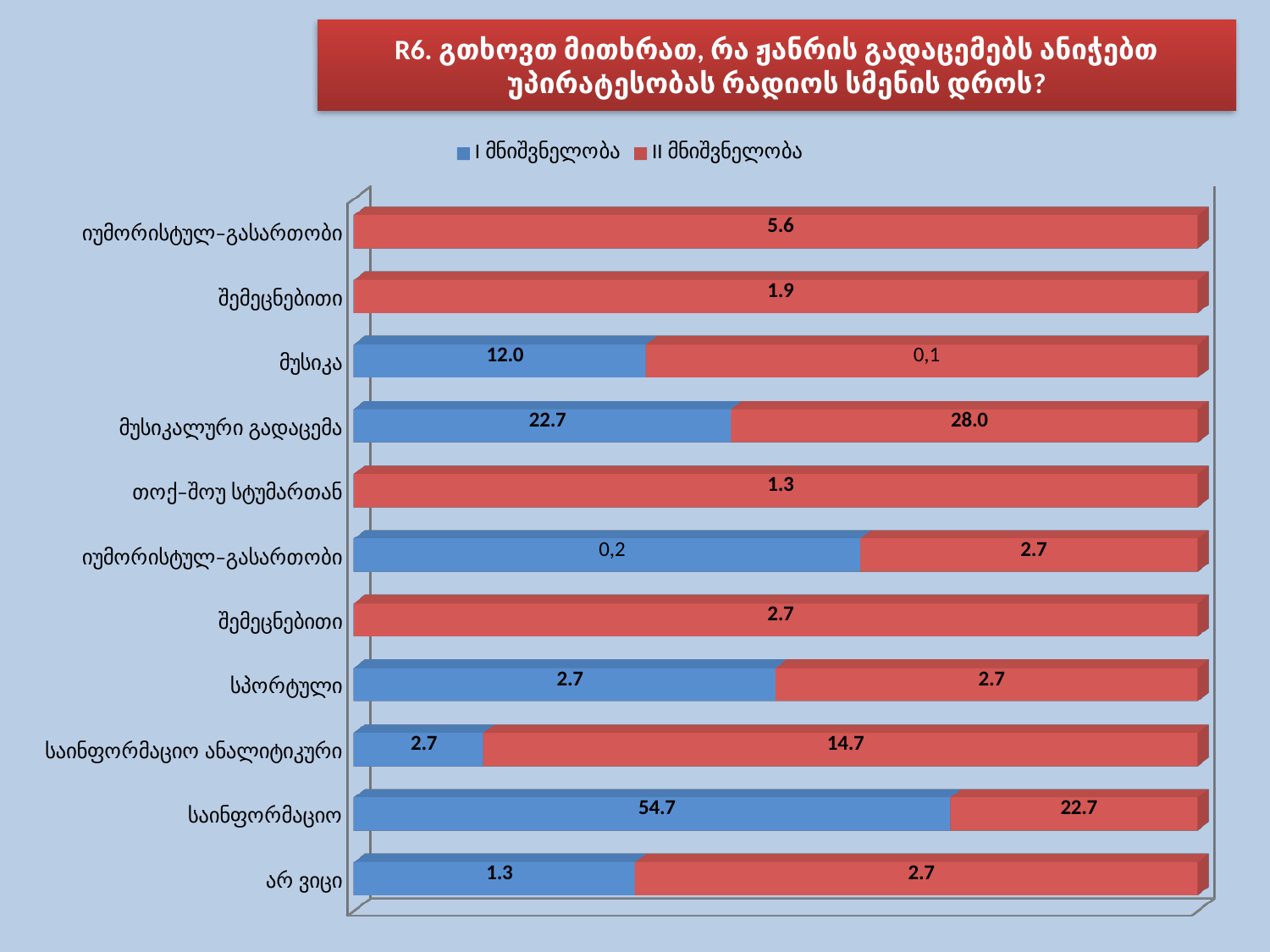
What is the value of I მნიშვნელობა for მუსიკა? 12.0 How many series does the legend list? 2 What is the value of I მნიშვნელობა for საინფორმაციო? 54.7 What is the value of II მნიშვნელობა for მუსიკალური გადაცემა? 28.0 Which category has the highest value for II მნიშვნელობა? მუსიკალური გადაცემა How many category bars are shown in the chart? 11 Which category has the highest value for I მნიშვნელობა? საინფორმაციო What kind of chart is shown on the slide? bar chart What is the value of II მნიშვნელობა for საინფორმაციო ანალიტიკური? 14.7 Which colour represents the II მნიშვნელობა series in the chart? red For მუსიკალური გადაცემა, which series has the larger value, I მნიშვნელობა or II მნიშვნელობა? II მნიშვნელობა For საინფორმაციო, what is the difference between the I მნიშვნელობა and II მნიშვნელობა values? 32.0